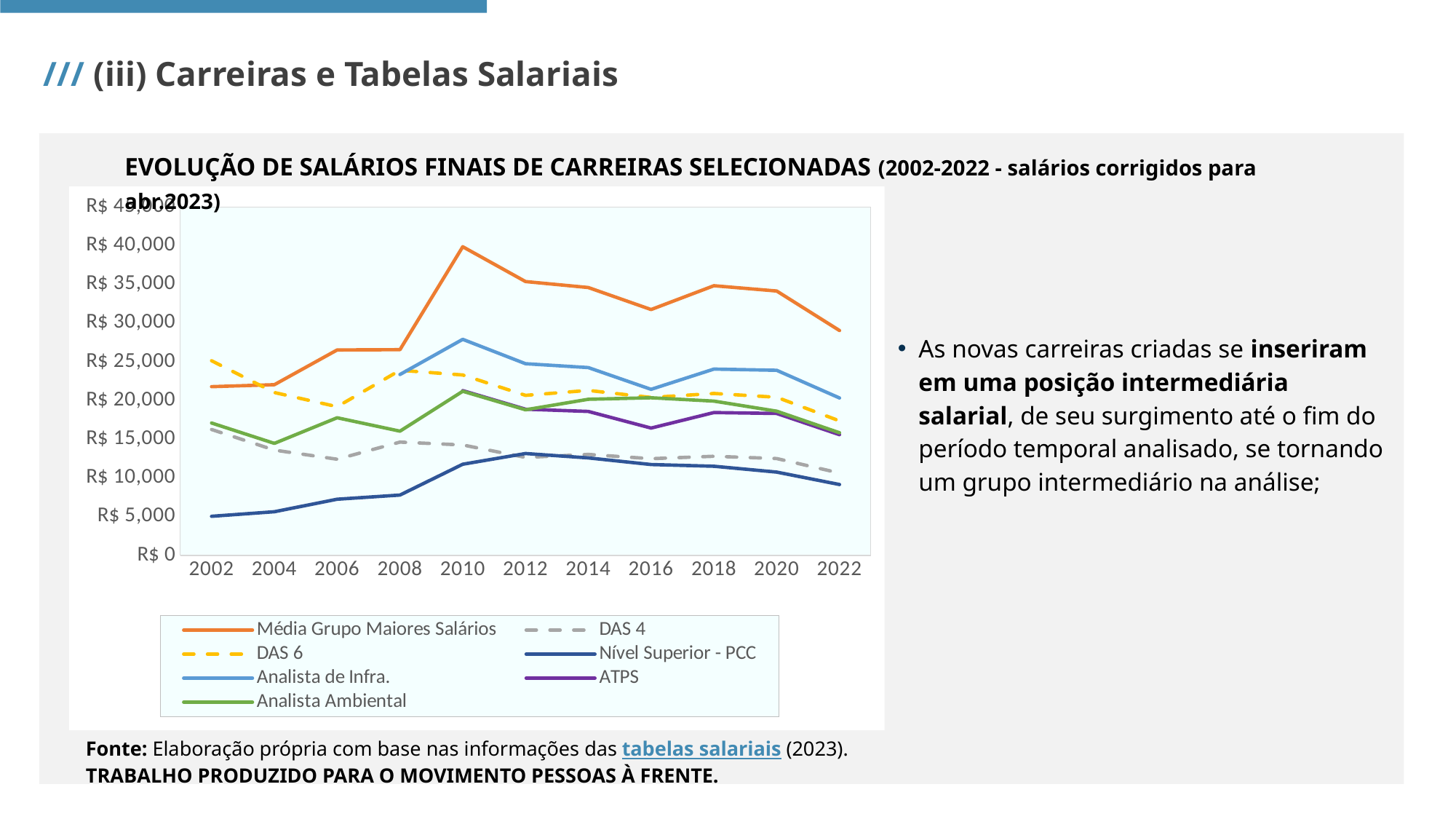
Is the value for DAS 4 in 2006 greater or less than R$ 15,000? less Is the value for Nível Superior - PCC in 2002 greater or less than R$ 10,000? less What kind of chart is shown on the slide? line chart How many series does the legend list? 7 In which year does the Média Grupo Maiores Salários series reach its highest value? 2010 Which series has the highest value in 2010? Média Grupo Maiores Salários Does the Nível Superior - PCC series rise or fall from 2002 to 2012? rise How many years are plotted along the x axis? 11 Which series is drawn as a grey dashed line? DAS 4 In 2002, which is larger: DAS 6 or Média Grupo Maiores Salários? DAS 6 Is the value for Média Grupo Maiores Salários in 2010 greater or less than R$ 35,000? greater Which series has the lowest value in 2022? Nível Superior - PCC